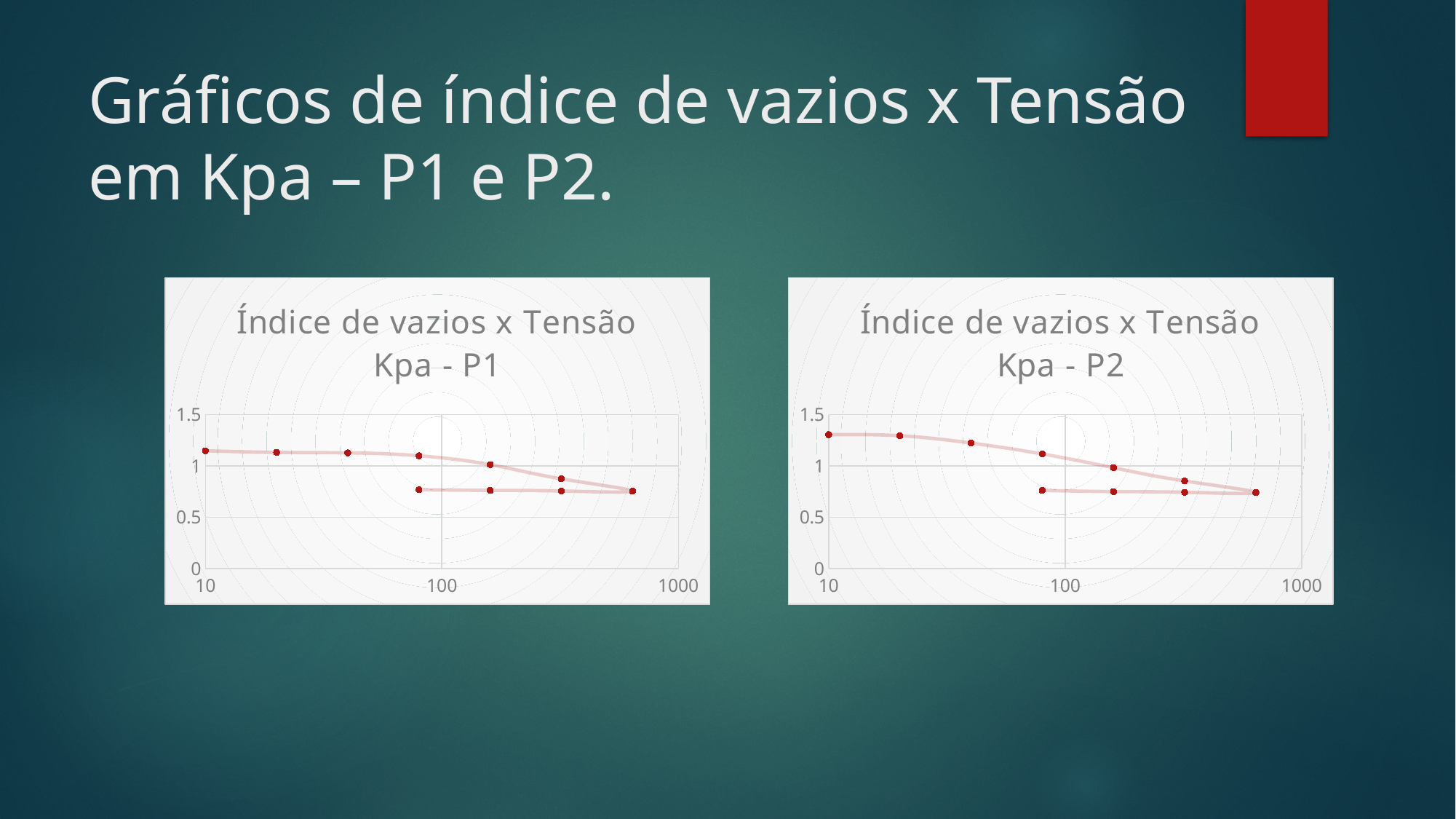
How many charts are shown on the slide? 2 Which chart has the larger value at a tension of 10, P1 or P2? P2 What is the title of the chart on the right? Índice de vazios x Tensão Kpa - P2 In the 'Índice de vazios x Tensão Kpa - P1' chart, is the value at the highest tension (rightmost point) greater or less than 1? less What kind of chart is the 'Índice de vazios x Tensão Kpa - P1' chart? scatter chart with lines In the 'Índice de vazios x Tensão Kpa - P1' chart, is the value at a tension of 10 greater or less than 1? greater In the 'Índice de vazios x Tensão Kpa - P2' chart, do the values of the upper curve rise or fall as tension increases? fall In the 'Índice de vazios x Tensão Kpa - P2' chart, is the value at the rightmost point greater or less than 1? less In the 'Índice de vazios x Tensão Kpa - P2' chart, at which tension value is the void index highest? 10 In the 'Índice de vazios x Tensão Kpa - P1' chart, do the values of the upper curve rise or fall as tension increases? fall What is the maximum value shown on the y axis of the 'Índice de vazios x Tensão Kpa - P1' chart? 1.5